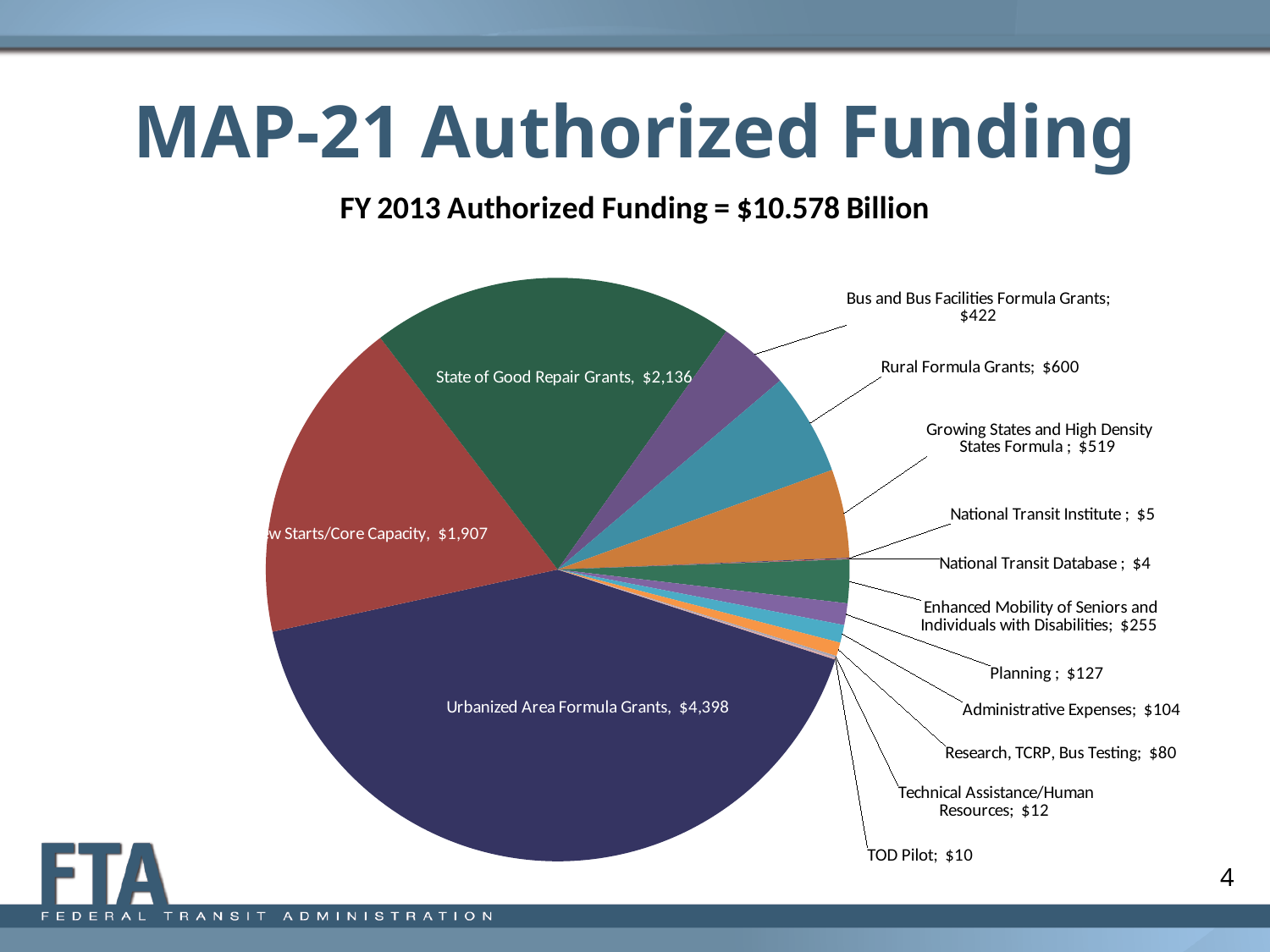
Which category has the smallest value? National Transit Database What is the value for Enhanced Mobility of Seniors and Individuals with Disabilities? $255 What is the value for TOD Pilot? $10 What is the value for State of Good Repair Grants? $2,136 What is the value for Rural Formula Grants? $600 Which category has the largest slice of the pie? Urbanized Area Formula Grants What total FY 2013 authorized funding is stated above the chart? $10.578 Billion What kind of chart is shown on the slide? pie chart What is the value for Urbanized Area Formula Grants? $4,398 How many slices does the pie chart have? 14 Which is larger, Planning or Administrative Expenses? Planning What is the difference between Rural Formula Grants and Bus and Bus Facilities Formula Grants? $178